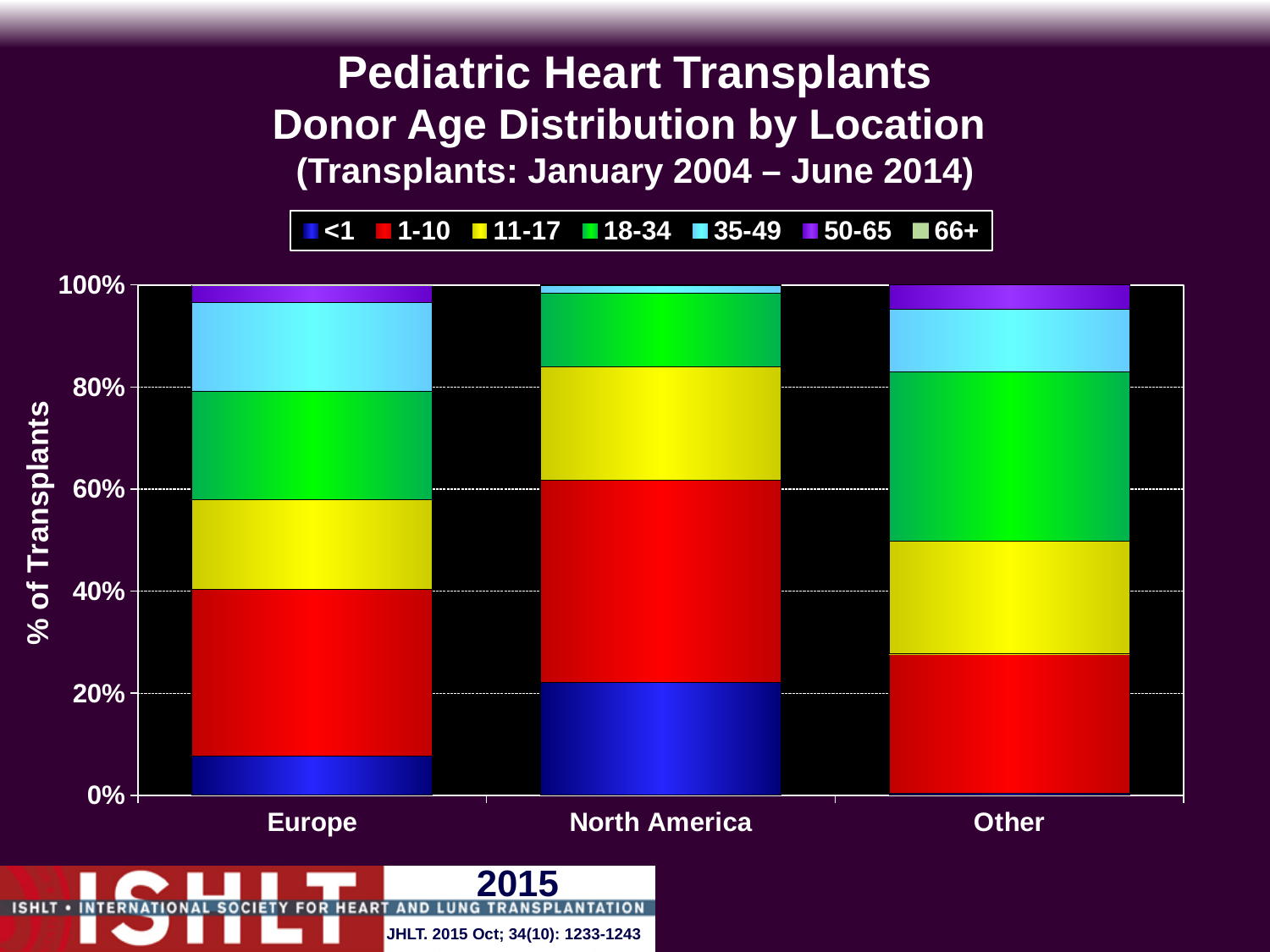
What kind of chart is shown on the slide? Stacked bar chart How many locations are shown on the x axis of the chart? 3 What is the total height of each stacked bar on the chart? 100% Is the <1 donor age share for Europe greater or less than 20%? less Is the 1-10 donor age share for North America greater or less than 20%? greater What is the label of the y axis? % of Transplants Is the 1-10 donor age segment larger for North America or for Other? North America Which location has the largest 18-34 donor age segment? Other Which location has the largest <1 donor age segment? North America What is the title of the chart? Pediatric Heart Transplants Donor Age Distribution by Location How many donor age groups does the legend list? 7 Which location has the smallest 35-49 donor age segment? North America